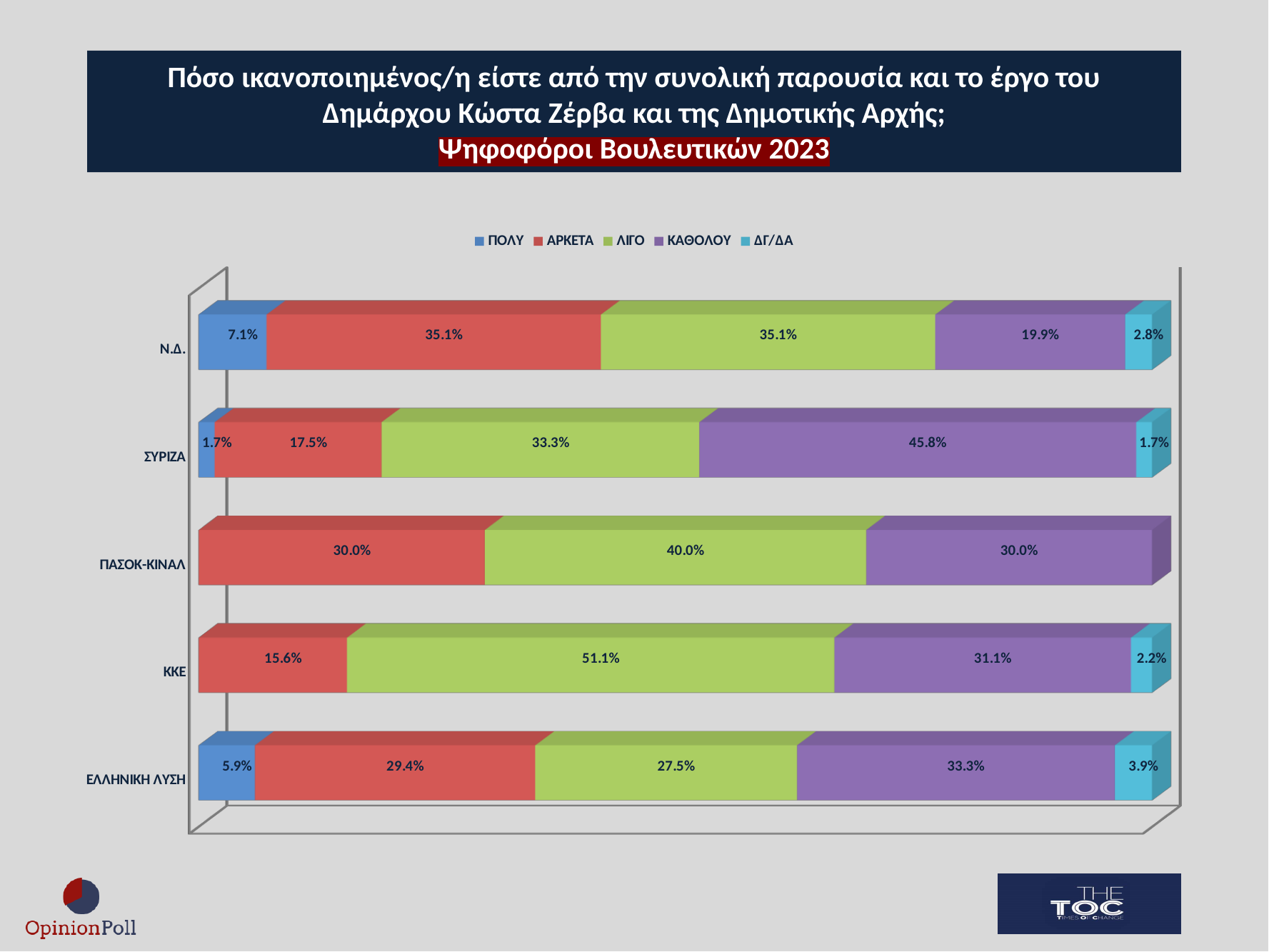
How many categories (parties) are shown on the chart? 5 Which category has the highest ΚΑΘΟΛΟΥ value? ΣΥΡΙΖΑ What is the difference between the ΛΙΓΟ values for ΚΚΕ and ΠΑΣΟΚ-ΚΙΝΑΛ? 11.1% Which is larger: the ΠΟΛΥ value for Ν.Δ. or the ΠΟΛΥ value for ΕΛΛΗΝΙΚΗ ΛΥΣΗ? Ν.Δ. What is the total of the ΠΑΣΟΚ-ΚΙΝΑΛ bar? 100.0% Which category has the lowest ΑΡΚΕΤΑ value? ΚΚΕ What is the ΔΓ/ΔΑ value for ΕΛΛΗΝΙΚΗ ΛΥΣΗ? 3.9% What is the ΛΙΓΟ value for ΚΚΕ? 51.1% What kind of chart is shown on the slide? Stacked bar chart What percentage of Ν.Δ. voters answered ΑΡΚΕΤΑ? 35.1% How many series does the legend list? 5 What is the ΚΑΘΟΛΟΥ value for ΣΥΡΙΖΑ? 45.8%